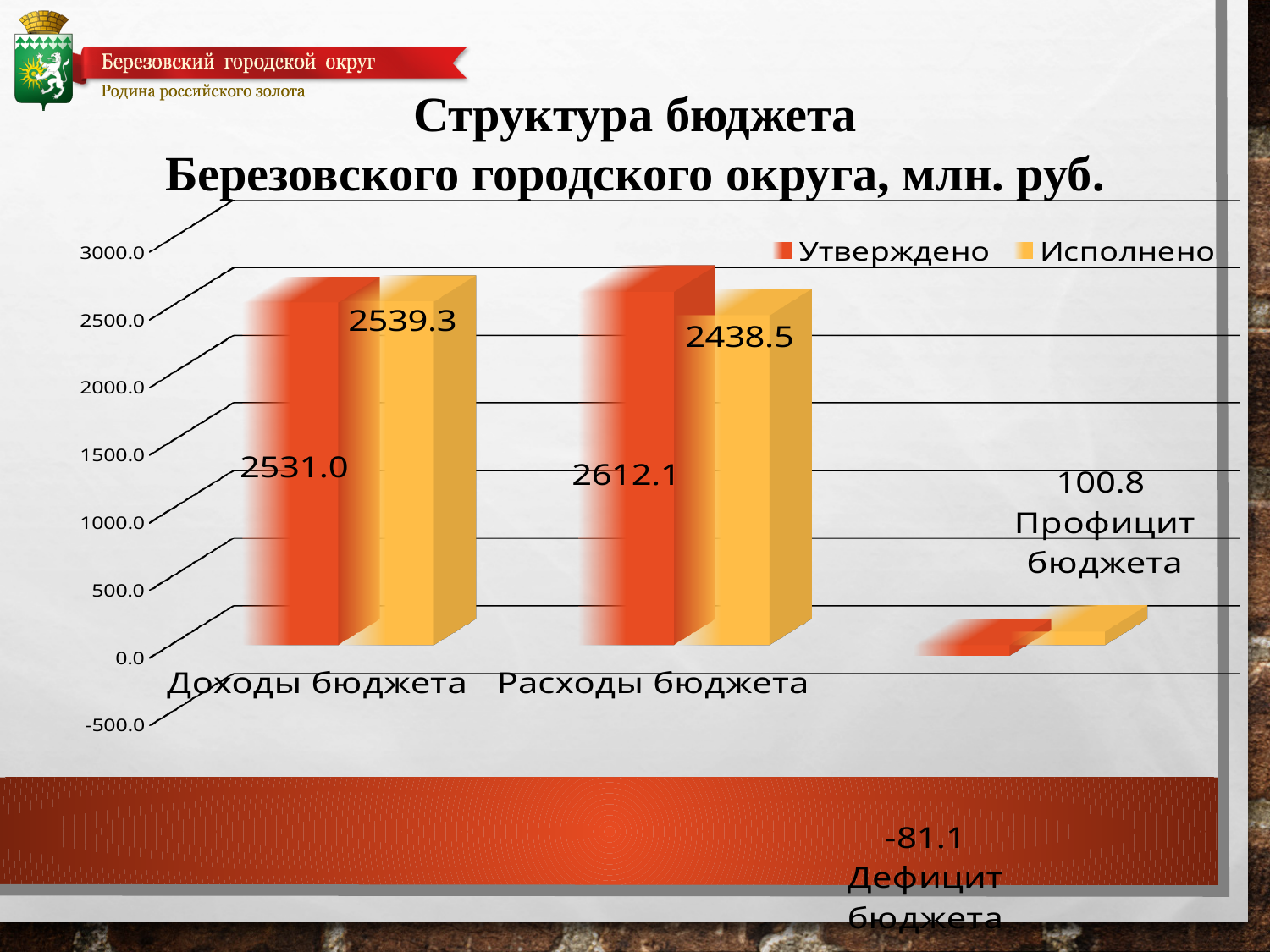
What is the Исполнено value for Доходы бюджета? 2539.3 What is the Утверждено value for Доходы бюджета? 2531.0 How many series does the legend list? 2 What value is labelled as Профицит бюджета on the chart? 100.8 What kind of chart is shown on the slide? Bar chart What is the difference between the Утверждено and Исполнено values for Расходы бюджета? 173.6 What is the Утверждено value for Расходы бюджета? 2612.1 What is the Исполнено value for Расходы бюджета? 2438.5 What is the difference between the Исполнено and Утверждено values for Доходы бюджета? 8.3 Which category has the highest Утверждено value? Расходы бюджета Which category has the highest Исполнено value? Доходы бюджета Which is larger for Расходы бюджета: the Утверждено value or the Исполнено value? Утверждено